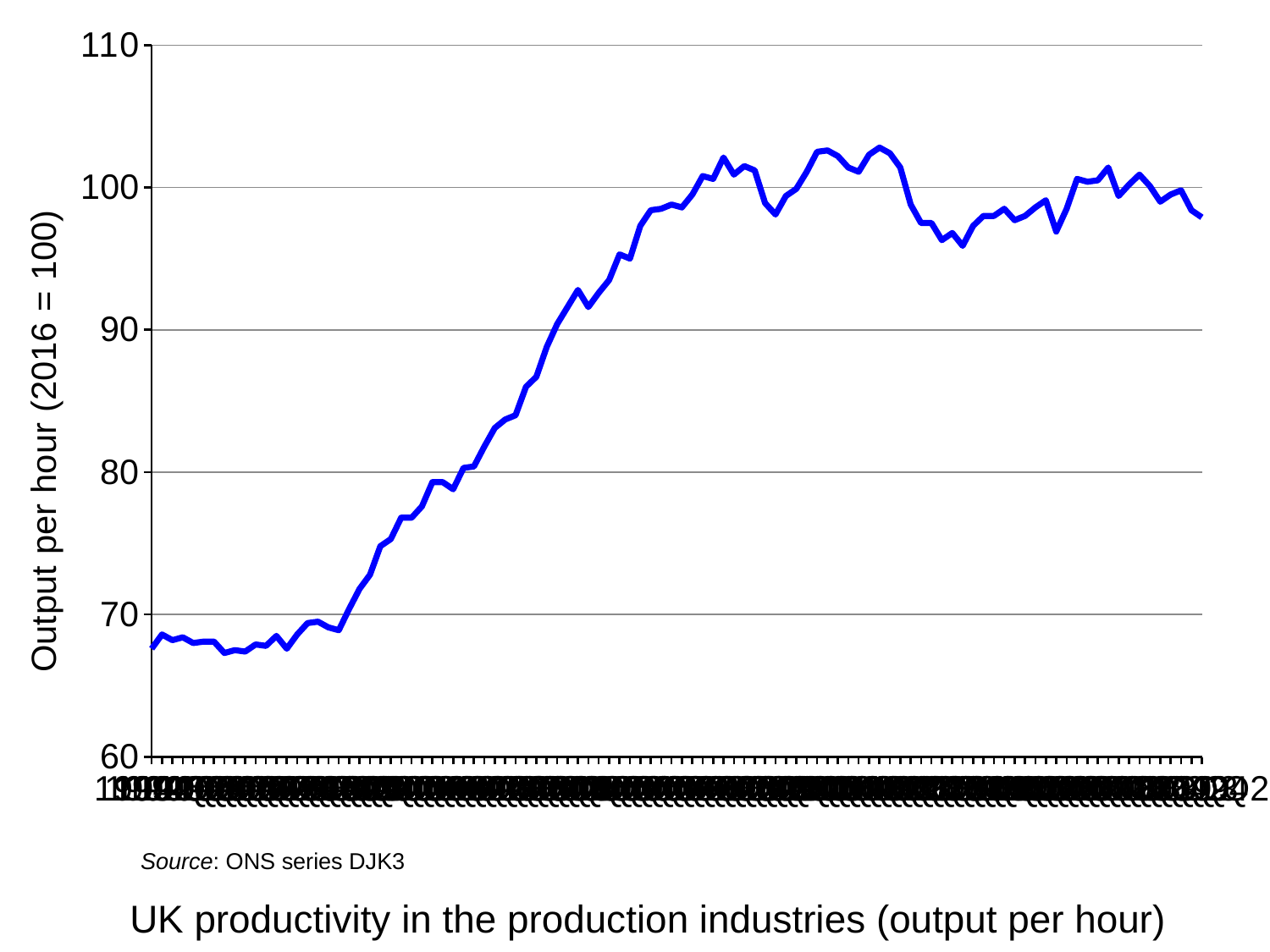
What is the highest value shown on the vertical axis? 110 Is the lowest point of the line greater or less than 70? less What is the title of the chart? UK productivity in the production industries (output per hour) Is the value at the end (right end) of the line greater or less than 100? less Is the value at the start (left end) of the line greater or less than 70? less Overall, does the plotted line rise or fall from the left of the x axis to the right? Rise What is the label on the vertical axis of the chart? Output per hour (2016 = 100) What kind of chart is shown on the slide? Line chart How many lines (series) are plotted on the chart? 1